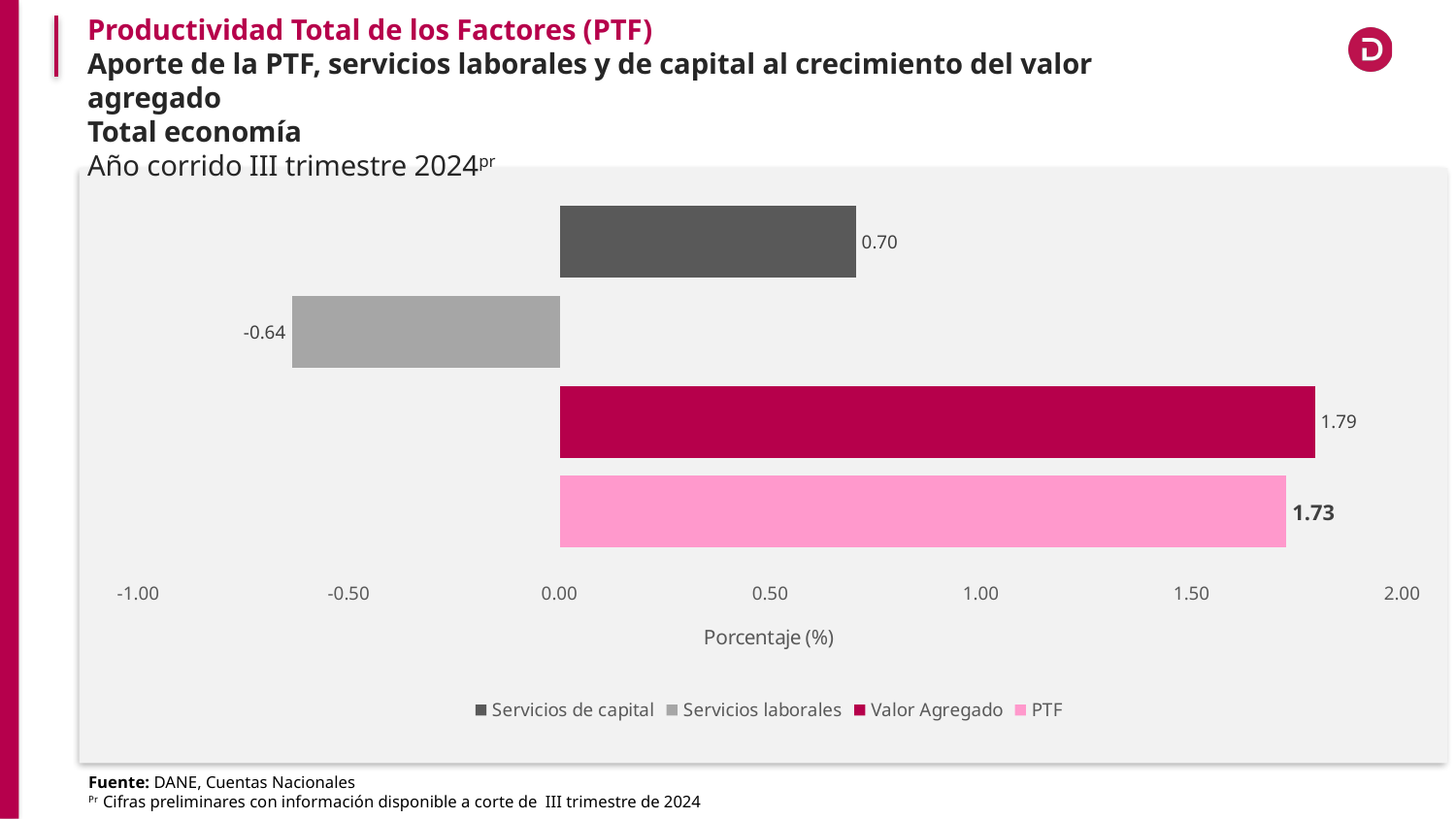
What kind of chart is shown on the slide? Bar chart Which is larger, the value for Servicios de capital or the value for PTF? PTF What is the value for Servicios laborales? -0.64 What is the value for Servicios de capital? 0.70 What is the label of the horizontal axis? Porcentaje (%) What is the value for Valor Agregado? 1.79 Which series has the lowest value? Servicios laborales What is the difference between the values for Servicios de capital and Servicios laborales? 1.34 Which series has the highest value? Valor Agregado What is the value for PTF? 1.73 What is the difference between the values for Valor Agregado and PTF? 0.06 How many series does the legend list? 4